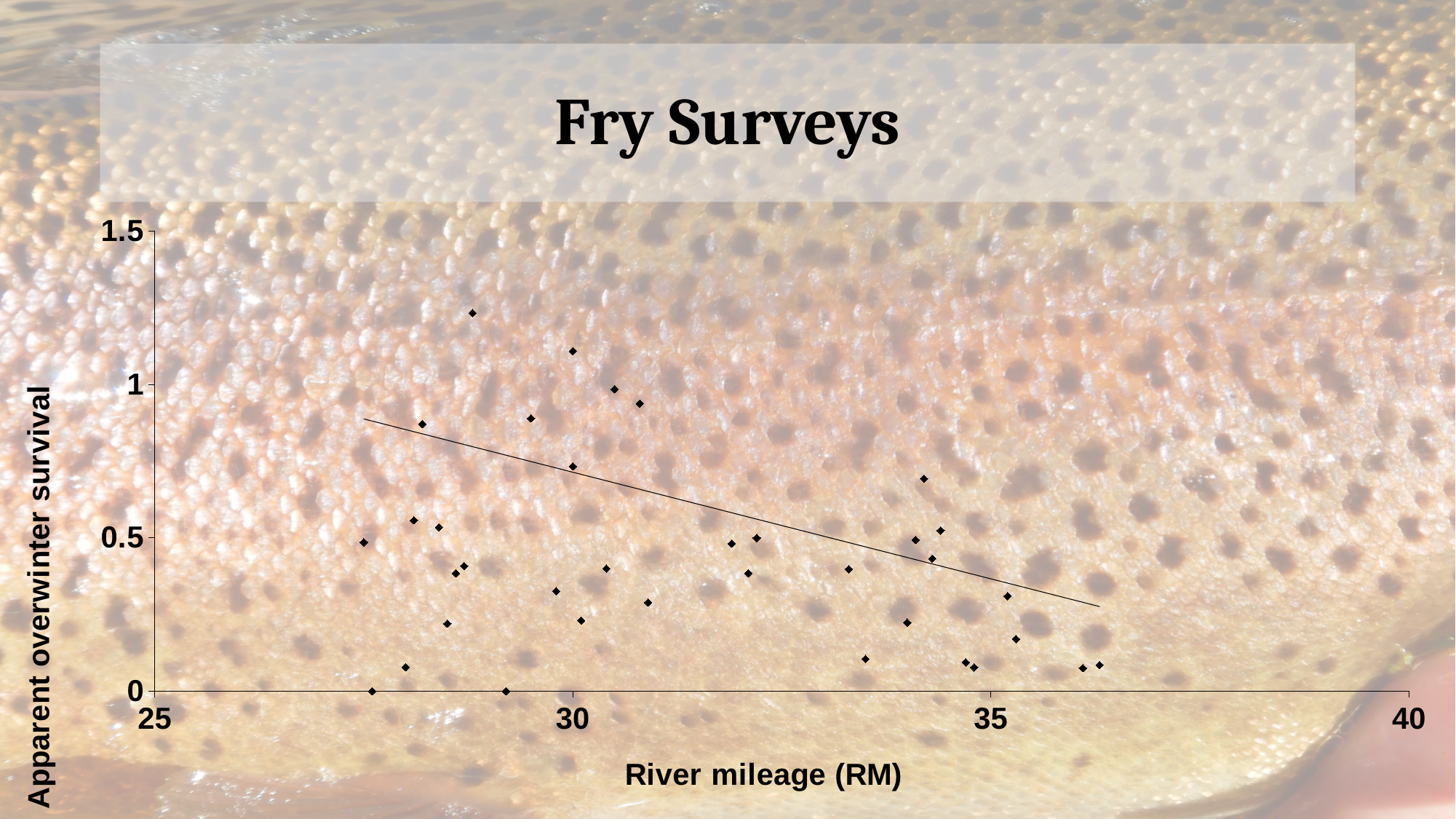
What is the label of the vertical axis? Apparent overwinter survival Is the river mileage of the point with the highest survival greater or less than 25? greater Does apparent overwinter survival generally increase or decrease with river mileage according to the fitted line? Decrease Is the highest plotted survival value greater or less than 1.5? less Does the trend line on the chart rise or fall as river mileage increases? Falls What is the title of the chart on the slide? Fry Surveys Is the lowest plotted survival value greater or less than 0.5? less What kind of chart is shown on the slide? Scatter plot